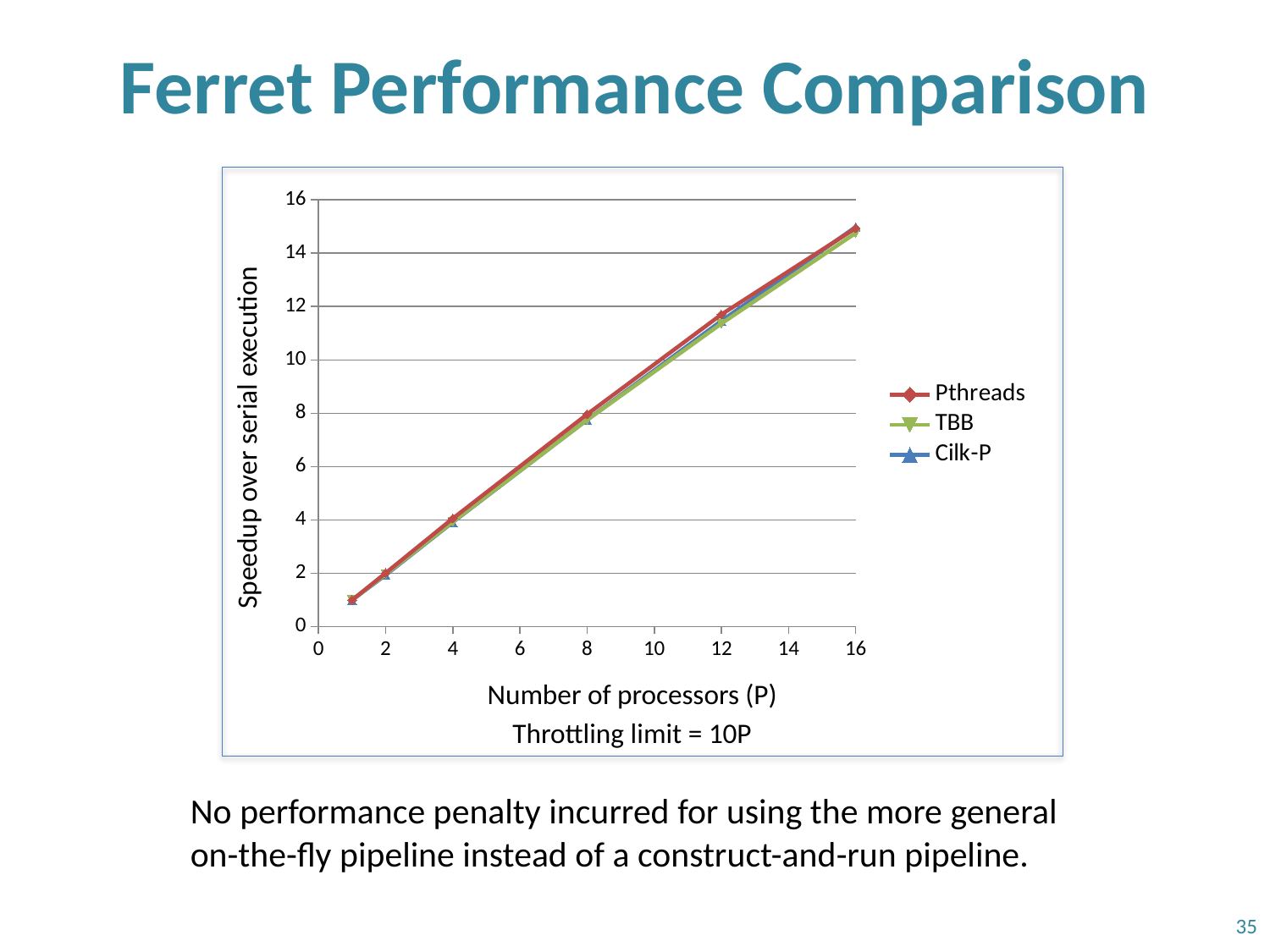
Is the Cilk-P speedup at 8 processors greater or less than 6? greater Which series are listed in the legend? Pthreads, TBB, Cilk-P Is the Pthreads speedup at 4 processors greater or less than 6? less What kind of chart is shown on the slide? line chart Do the speedup values rise or fall as the number of processors increases? rise What is the label of the y axis? Speedup over serial execution How many data points are plotted for each series? 6 What is the maximum value shown on the y axis? 16 How many series does the legend list? 3 Is the TBB speedup at 1 processor greater or less than 2? less